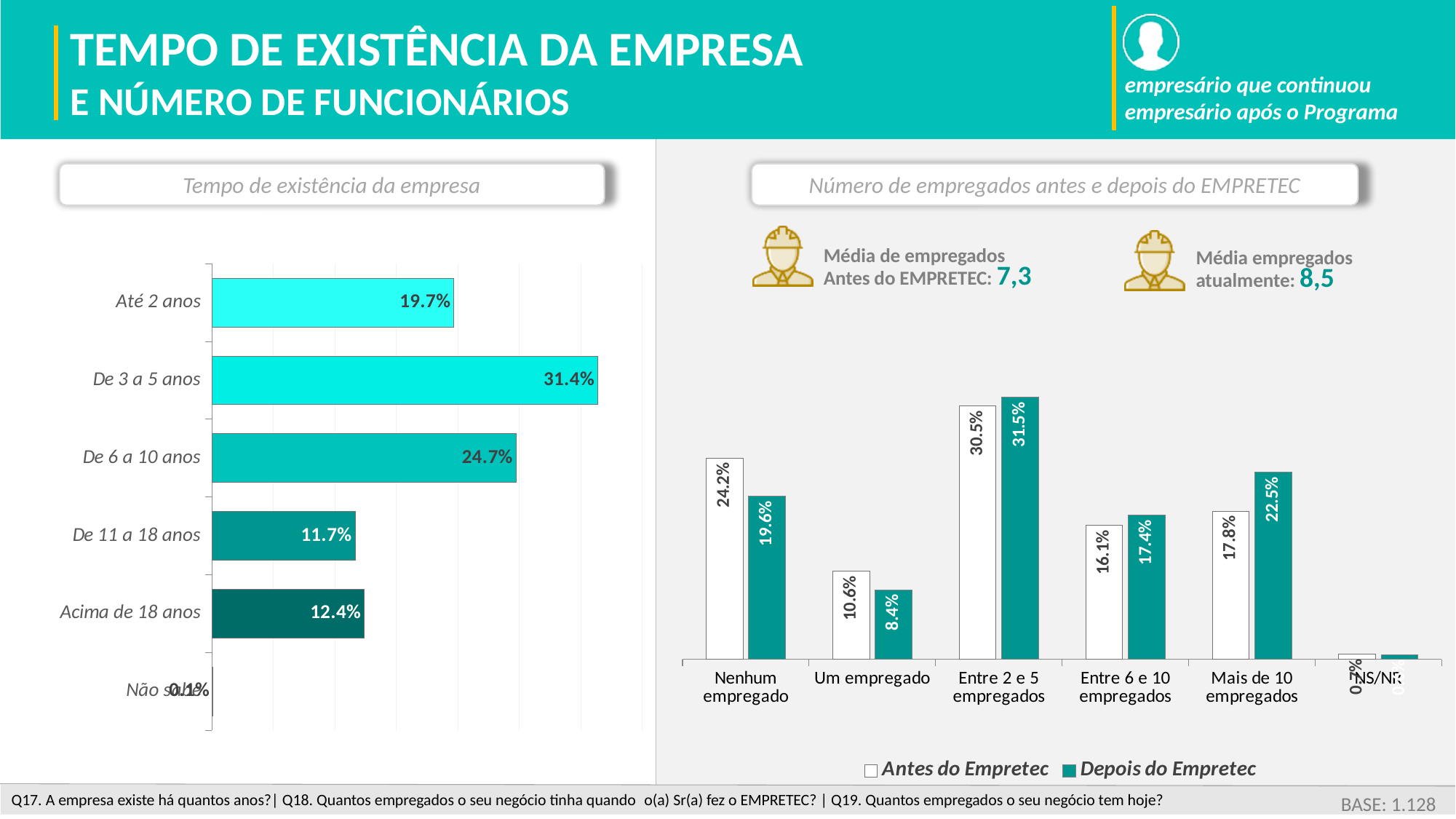
In the 'Tempo de existência da empresa' chart, which is larger: 'De 11 a 18 anos' or 'Acima de 18 anos'? Acima de 18 anos In the 'Número de empregados antes e depois do EMPRETEC' chart, for 'Mais de 10 empregados', which is larger: 'Antes do Empretec' or 'Depois do Empretec'? Depois do Empretec In the 'Tempo de existência da empresa' chart, what is the value for 'De 3 a 5 anos'? 31.4% In the 'Número de empregados antes e depois do EMPRETEC' chart, which category has the highest 'Depois do Empretec' value? Entre 2 e 5 empregados How many series does the legend of the 'Número de empregados antes e depois do EMPRETEC' chart list? 2 In the 'Número de empregados antes e depois do EMPRETEC' chart, what colour are the 'Depois do Empretec' bars? Teal What kind of chart is the 'Tempo de existência da empresa' chart? Bar chart In the 'Tempo de existência da empresa' chart, what is the difference between 'De 6 a 10 anos' and 'Até 2 anos'? 5.0% In the 'Número de empregados antes e depois do EMPRETEC' chart, what is the difference between the 'Antes do Empretec' and 'Depois do Empretec' values for 'Um empregado'? 2.2% In the 'Número de empregados antes e depois do EMPRETEC' chart, what is the 'Depois do Empretec' value for 'Mais de 10 empregados'? 22.5% In the 'Tempo de existência da empresa' chart, which category has the highest value? De 3 a 5 anos In the 'Número de empregados antes e depois do EMPRETEC' chart, what is the 'Antes do Empretec' value for 'Nenhum empregado'? 24.2%